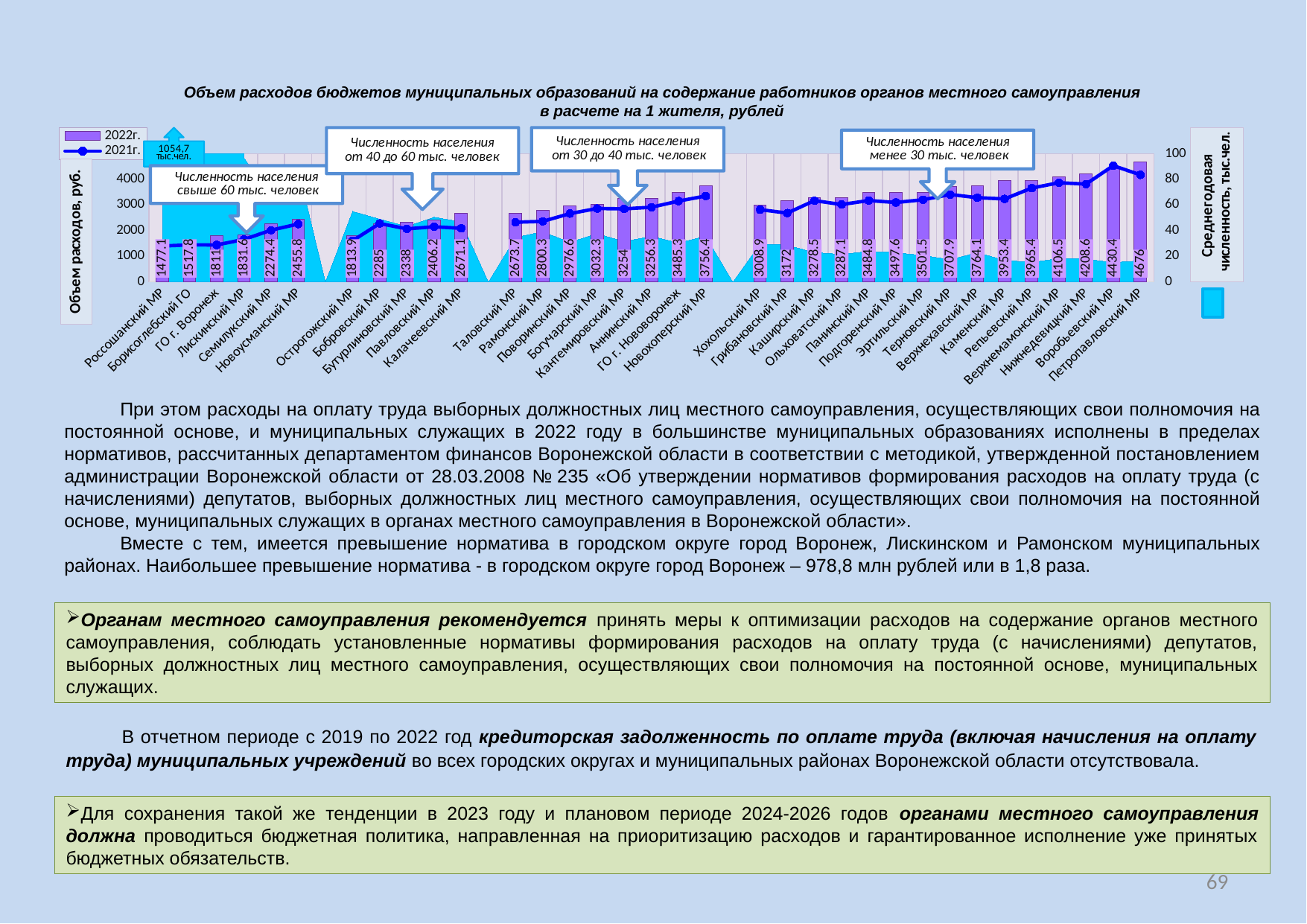
Which municipality has the lowest 2022г. bar value? Россошанский МР Which municipality has the highest 2022г. bar value? Петропавловский МР Do the 2022г. bar values rise or fall from Хохольский МР to Петропавловский МР? rise What is the 2022г. value for Рамонский МР? 2800.3 What is the label of the left vertical axis? Объем расходов, руб. How many municipalities are shown on the x axis? 34 What is the 2022г. value for Петропавловский МР? 4676 Which has the larger 2022г. value, Новоусманский МР or Острогожский МР? Новоусманский МР How many series does the legend list? 2 What is the 2022г. value for ГО г. Воронеж? 1811 Is the 2021г. line value for Петропавловский МР greater or less than 60 on the right axis? greater What is the difference between the 2022г. values for Петропавловский МР and Воробьевский МР? 245.6